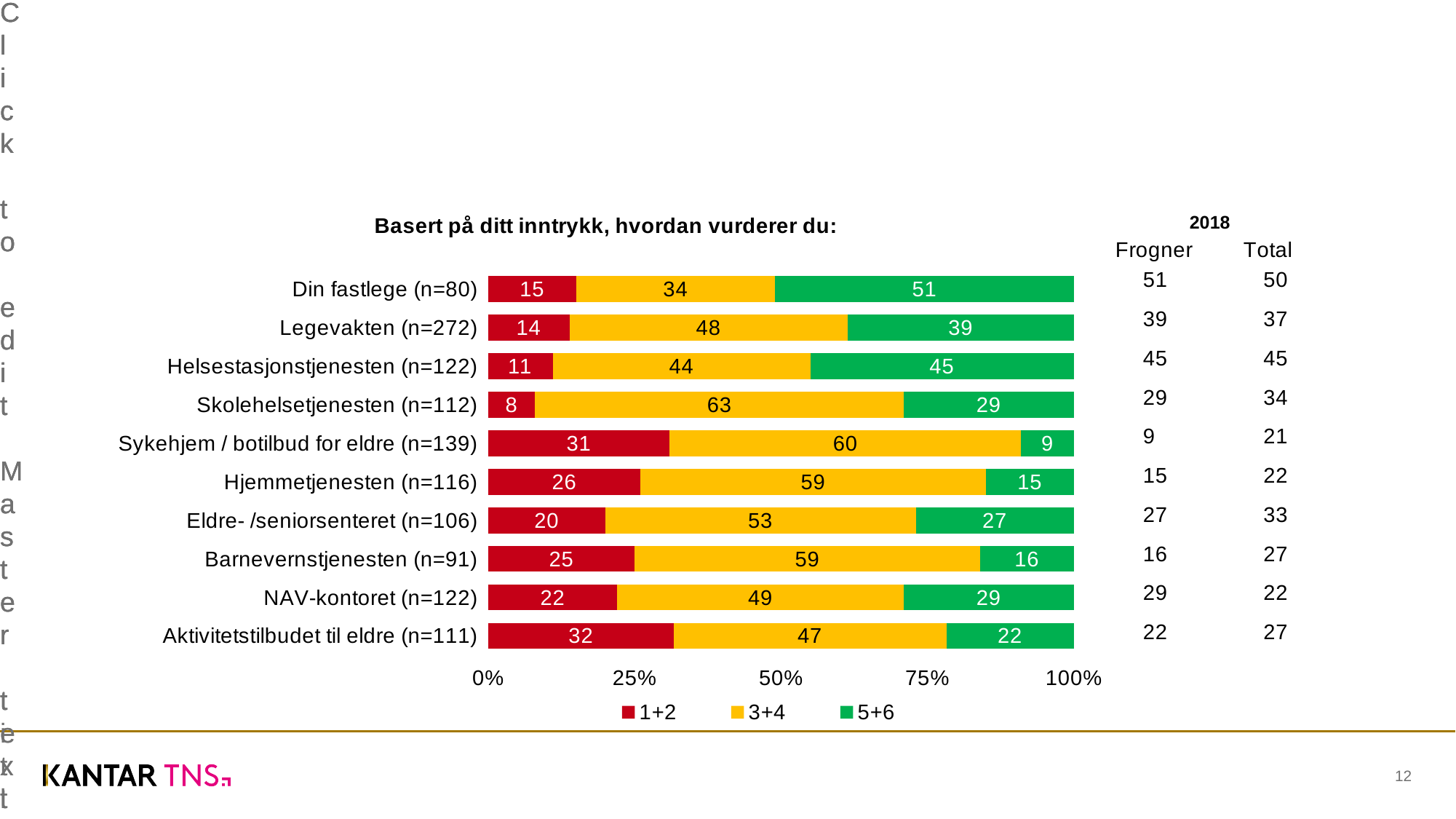
Which category has the lowest value in the 5+6 series? Sykehjem / botilbud for eldre (n=139) How many categories are shown in the chart? 10 What is the value of the 1+2 series for Sykehjem / botilbud for eldre (n=139)? 31 What is the difference between the 5+6 value for Din fastlege (n=80) and the 5+6 value for Sykehjem / botilbud for eldre (n=139)? 42 Which category has the lowest value in the 1+2 series? Skolehelsetjenesten (n=112) What is the value of the 5+6 series for Din fastlege (n=80)? 51 What kind of chart is shown on the slide? Stacked bar chart What is the value of the 3+4 series for Skolehelsetjenesten (n=112)? 63 Which is larger: the 3+4 value for Legevakten (n=272) or the 3+4 value for Hjemmetjenesten (n=116)? Hjemmetjenesten (n=116) Which category has the highest value in the 5+6 series? Din fastlege (n=80) What is the total of the stacked bar for Din fastlege (n=80)? 100 How many series does the legend list? 3